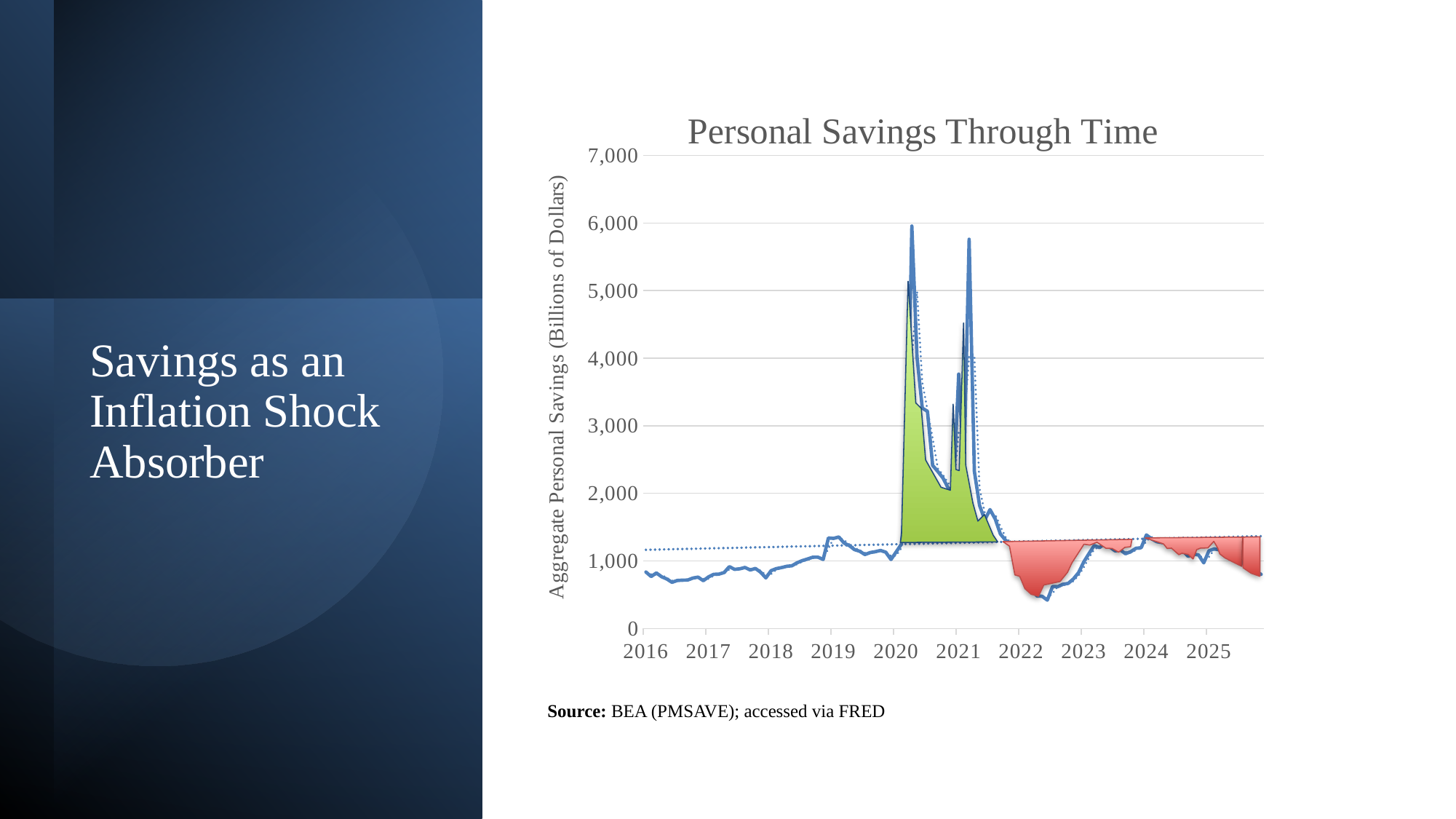
Is the lowest value reached in 2022 greater or less than 1,000? less Is the value at the start of 2019 greater or less than 2,000? less Is the peak value reached in 2020 greater or less than 5,000? greater What kind of chart is shown on the slide? line chart Which is higher, the peak value in 2020 or the value at the start of 2019? the peak value in 2020 In which year does the line reach its highest value? 2020 Does the line generally rise or fall from 2016 to 2019? rise What is the title of the chart? Personal Savings Through Time What colour is the shaded area between the line and the dotted trend line during 2020 and 2021? green How many year labels are shown on the x axis? 10